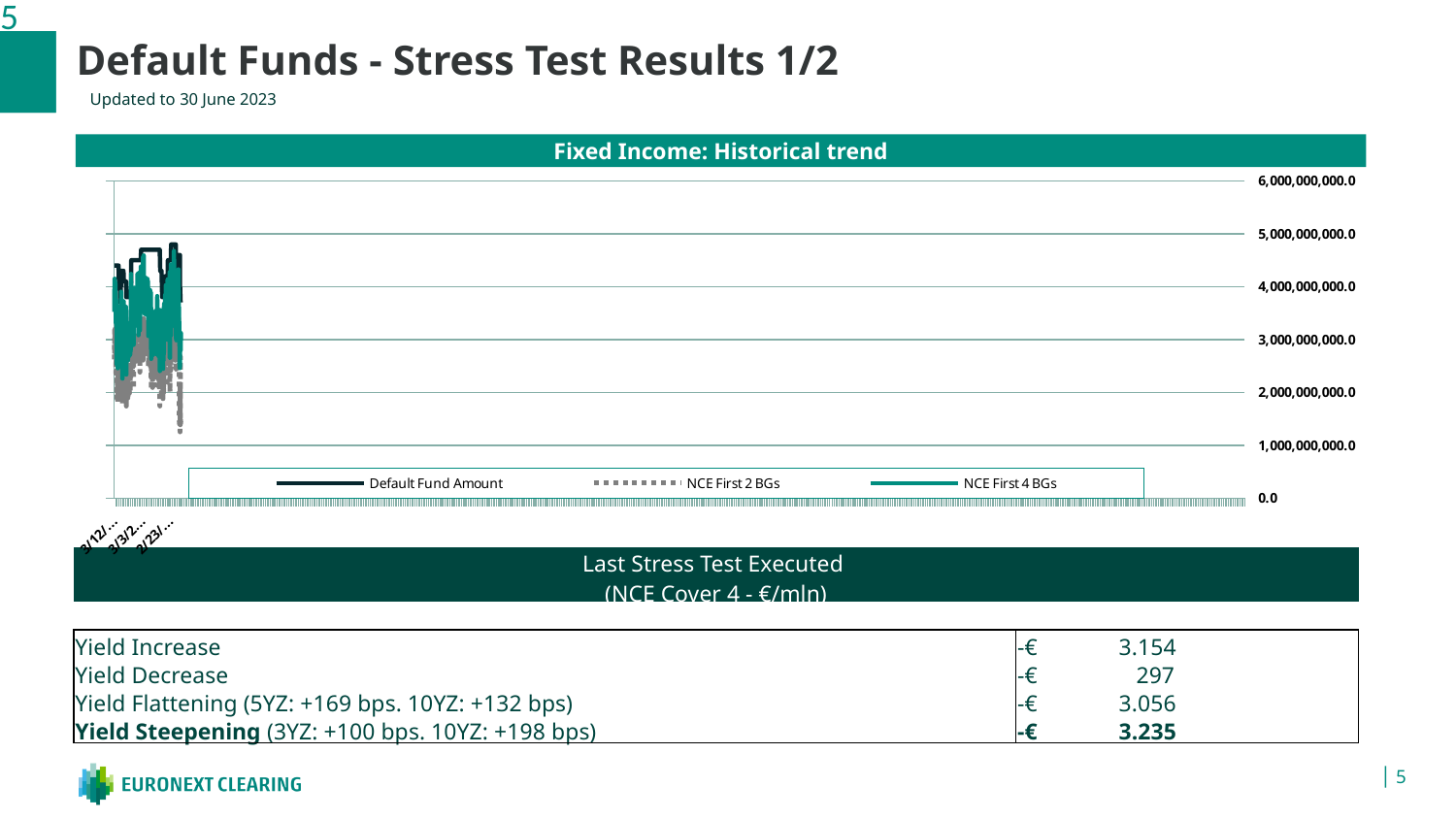
In the 'Fixed Income: Historical trend' chart, is the peak value of the Default Fund Amount series greater or less than 4,000,000,000.0? greater In the 'Fixed Income: Historical trend' chart, is the lowest value of the NCE First 2 BGs series greater or less than 3,000,000,000.0? less What is the highest value shown on the vertical axis of the 'Fixed Income: Historical trend' chart? 6,000,000,000.0 What kind of chart is shown under the heading 'Fixed Income: Historical trend'? line chart What is the lowest value shown on the vertical axis of the 'Fixed Income: Historical trend' chart? 0.0 What are the three series named in the legend of the 'Fixed Income: Historical trend' chart? Default Fund Amount, NCE First 2 BGs, NCE First 4 BGs In the 'Fixed Income: Historical trend' chart, which series reaches the highest values? Default Fund Amount How many series does the legend of the 'Fixed Income: Historical trend' chart list? 3 In the 'Fixed Income: Historical trend' chart, which series is drawn as a dotted line? NCE First 2 BGs How many tick labels are printed on the vertical axis of the 'Fixed Income: Historical trend' chart? 7 In the 'Fixed Income: Historical trend' chart, is the peak value of the Default Fund Amount series greater or less than 6,000,000,000.0? less In the 'Fixed Income: Historical trend' chart, which series has the lowest values? NCE First 2 BGs